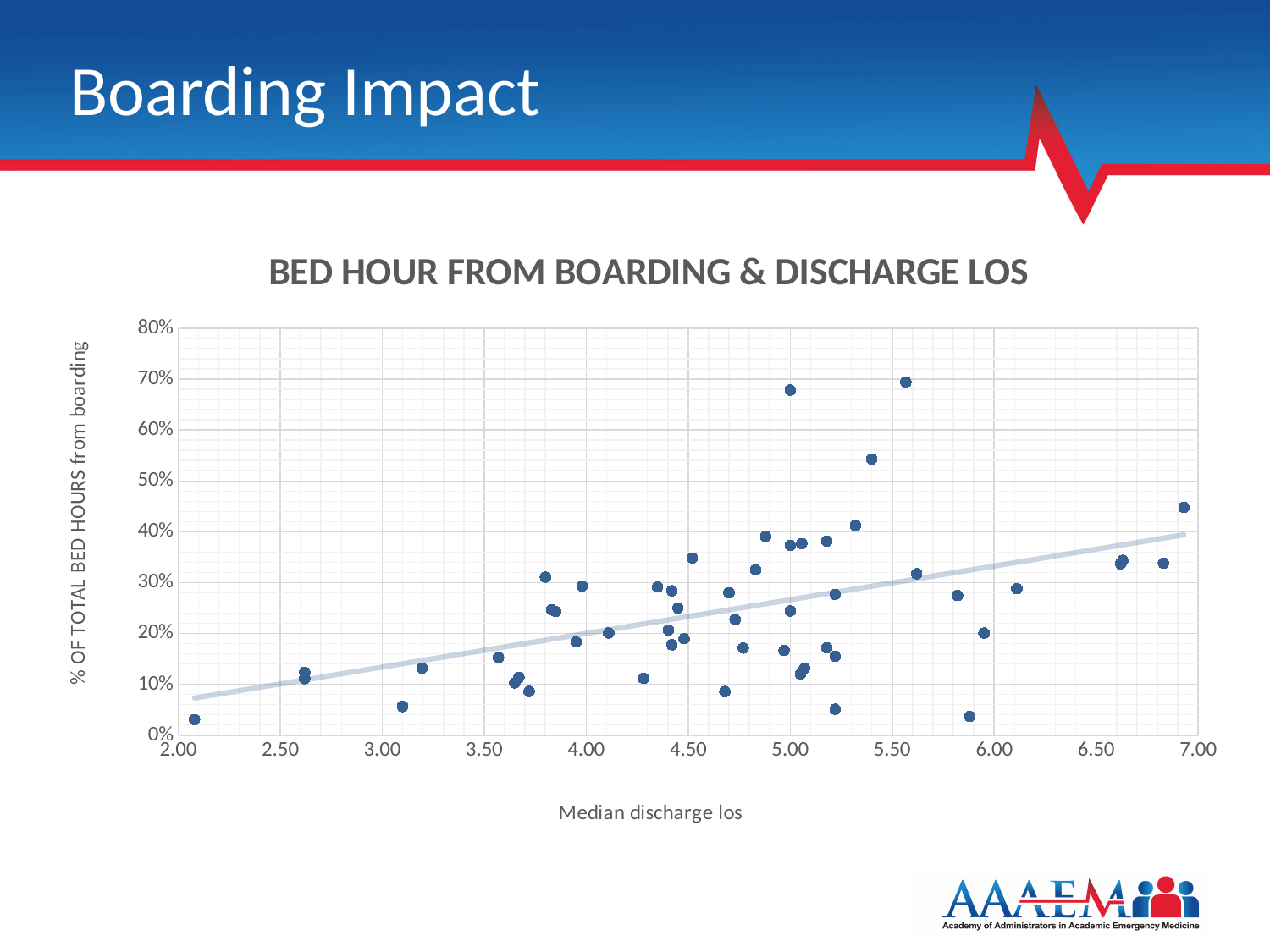
Is the value for the point near 3.10 on the x axis greater or less than 10%? less Does the trend line rise or fall as median discharge LOS increases? Rises What is the label of the x axis? Median discharge los What kind of chart is shown on the slide? Scatter plot What is the title of the chart? BED HOUR FROM BOARDING & DISCHARGE LOS Is the value for the leftmost point (near 2.07 on the x axis) greater or less than 10%? less Is the value for the highest point on the chart greater or less than 60%? greater What is the maximum value shown on the y axis? 80%